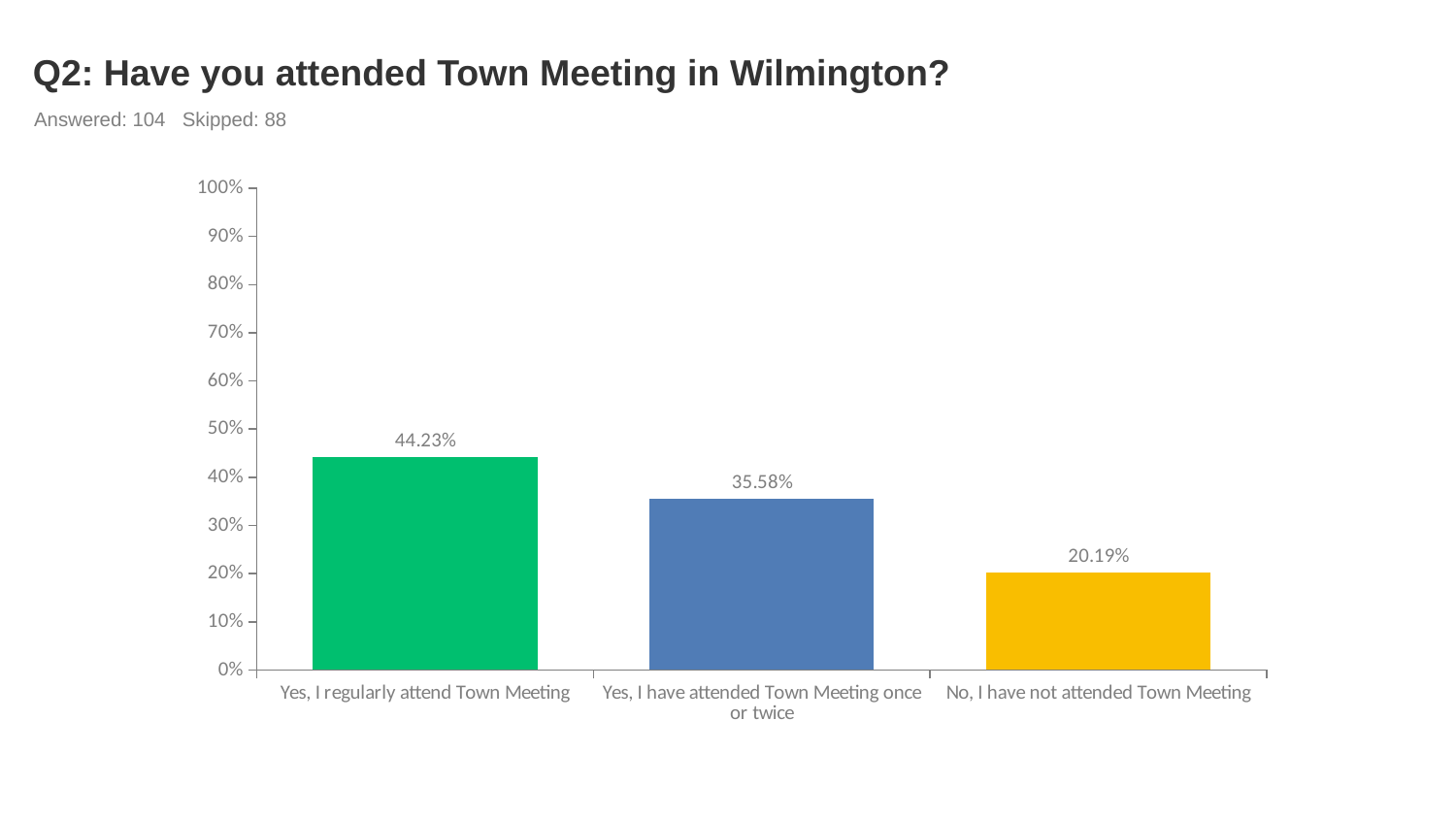
How many people answered this question according to the slide? 104 Which response category has the lowest value? No, I have not attended Town Meeting What percentage of respondents have not attended Town Meeting? 20.19% Which response category has the highest value? Yes, I regularly attend Town Meeting What percentage of respondents said they regularly attend Town Meeting? 44.23% What is the value for "Yes, I have attended Town Meeting once or twice"? 35.58% What is the difference between the values for "Yes, I regularly attend Town Meeting" and "No, I have not attended Town Meeting"? 24.04% Which is larger: the value for "Yes, I have attended Town Meeting once or twice" or the value for "No, I have not attended Town Meeting"? Yes, I have attended Town Meeting once or twice Is the value for "Yes, I regularly attend Town Meeting" greater or less than 50%? less How many response categories are shown in the chart? 3 What kind of chart is shown on the slide? Bar chart What is the difference between the values for "Yes, I regularly attend Town Meeting" and "Yes, I have attended Town Meeting once or twice"? 8.65%